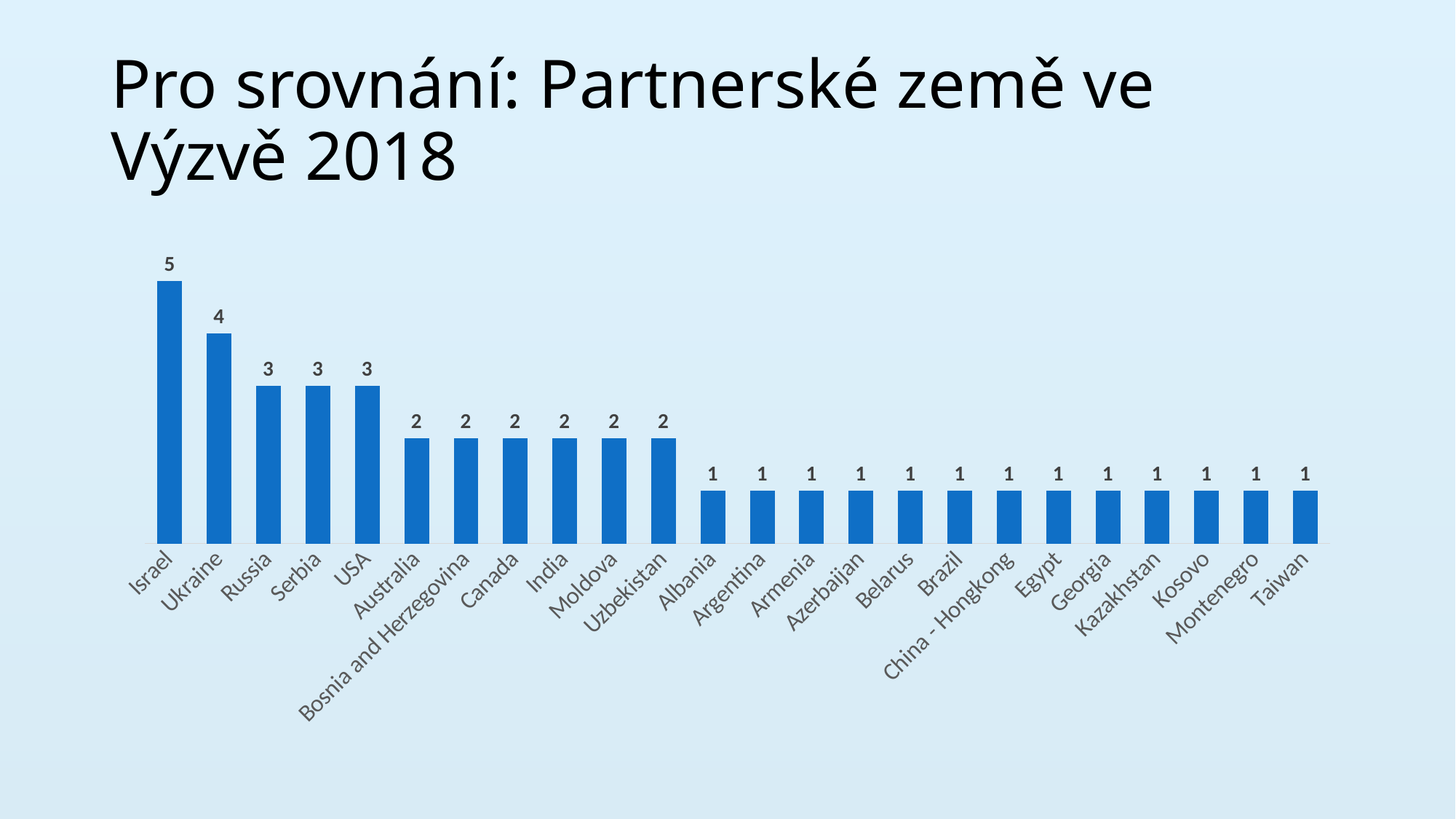
How many countries are shown on the chart? 24 What is the value for Ukraine? 4 What is the difference between the values for Israel and Ukraine? 1 What is the value for Kazakhstan? 1 What is the value for Israel? 5 What is the difference between the values for Russia and Albania? 2 What is the value for Bosnia and Herzegovina? 2 Do the values rise or fall from left to right along the x axis? Fall How many countries have a value of 1? 13 What kind of chart is shown on the slide? Bar chart Which has a larger value, Serbia or Canada? Serbia Which country has the highest value? Israel